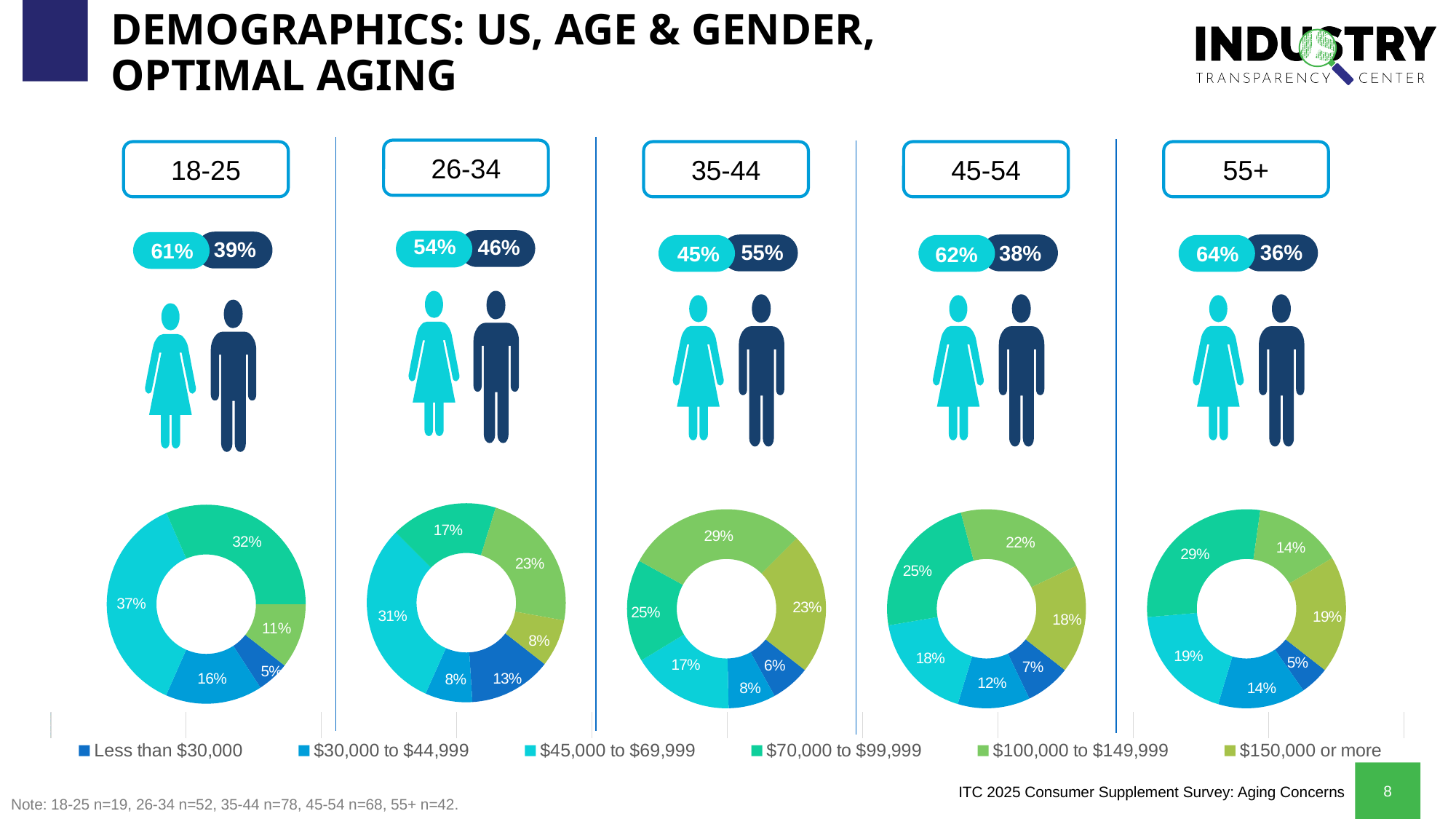
What kind of chart is used to show the income distribution for each age group? Donut (pie) chart In the 18-25 donut chart, what is the largest slice value? 37% In the 45-54 age group, what is the difference between the female and male percentages? 24 percentage points In the 35-44 age group, what percentage is shown for males (the dark blue figure)? 55% How many income categories does the legend at the bottom list? 6 In the 26-34 donut chart, what is the largest slice value? 31% In the 55+ donut chart, what is the smallest slice value? 5% Which age group has the lowest female percentage? 35-44 How many age groups are shown on the slide? 5 In the 18-25 age group, what percentage is shown for females (the cyan figure)? 61% Which age group has the highest female percentage? 55+ Is the female percentage larger in the 18-25 group or the 26-34 group? 18-25